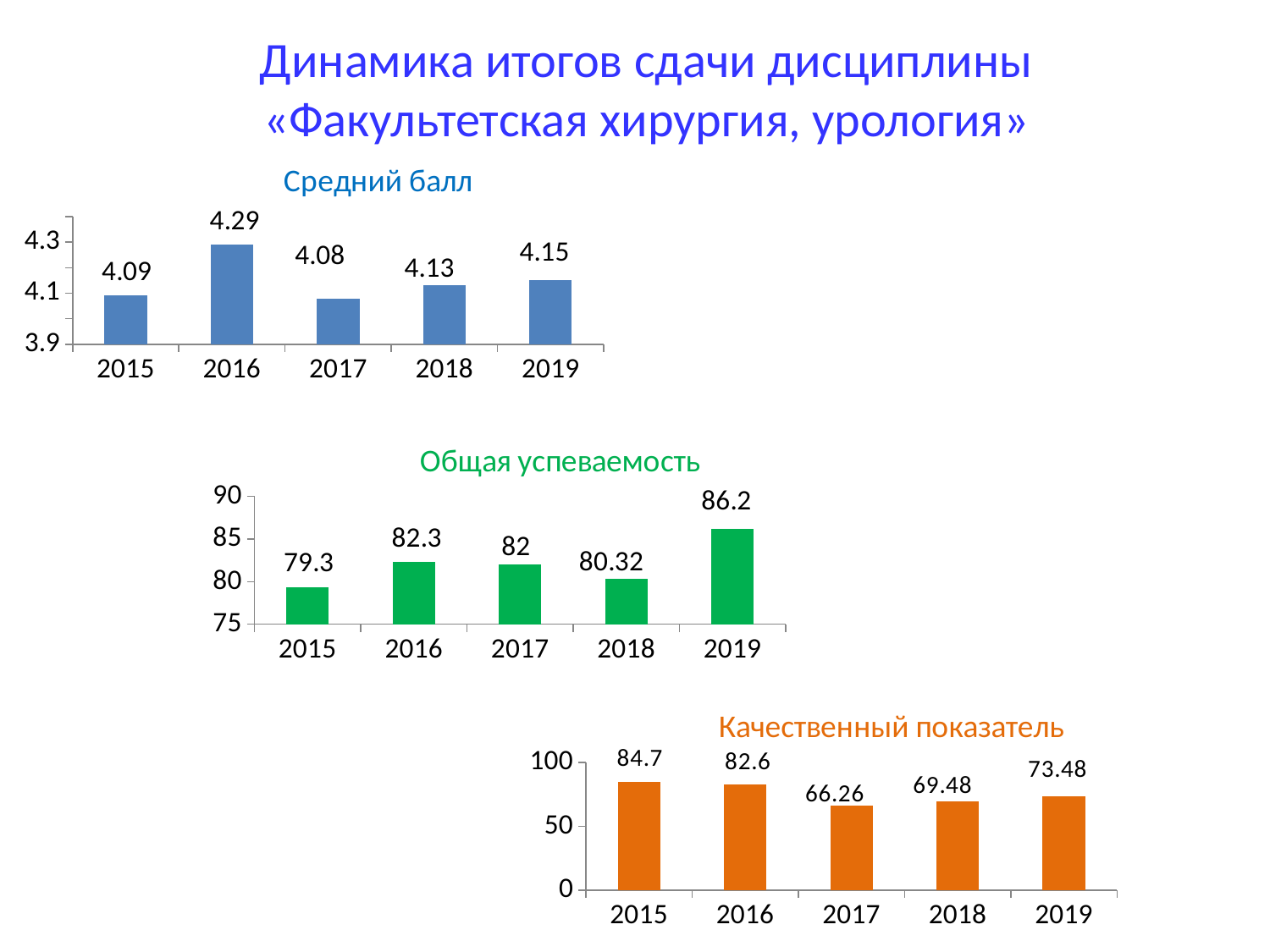
In the 'Общая успеваемость' chart, which year has the highest value? 2019 What type of chart is the 'Общая успеваемость' chart? Bar chart How many charts are on the slide? 3 In the 'Качественный показатель' chart, what is the value for 2017? 66.26 How many years are shown on the x axis of the 'Качественный показатель' chart? 5 In the 'Средний балл' chart, which year has the lowest value? 2017 In the 'Качественный показатель' chart, what is the difference between the values for 2015 and 2019? 11.22 In the 'Средний балл' chart, what is the value for 2016? 4.29 In the 'Общая успеваемость' chart, which is larger, the value for 2016 or the value for 2017? 2016 In the 'Общая успеваемость' chart, what is the value for 2018? 80.32 In the 'Качественный показатель' chart, which year has the highest value? 2015 In the 'Средний балл' chart, what is the difference between the values for 2016 and 2017? 0.21